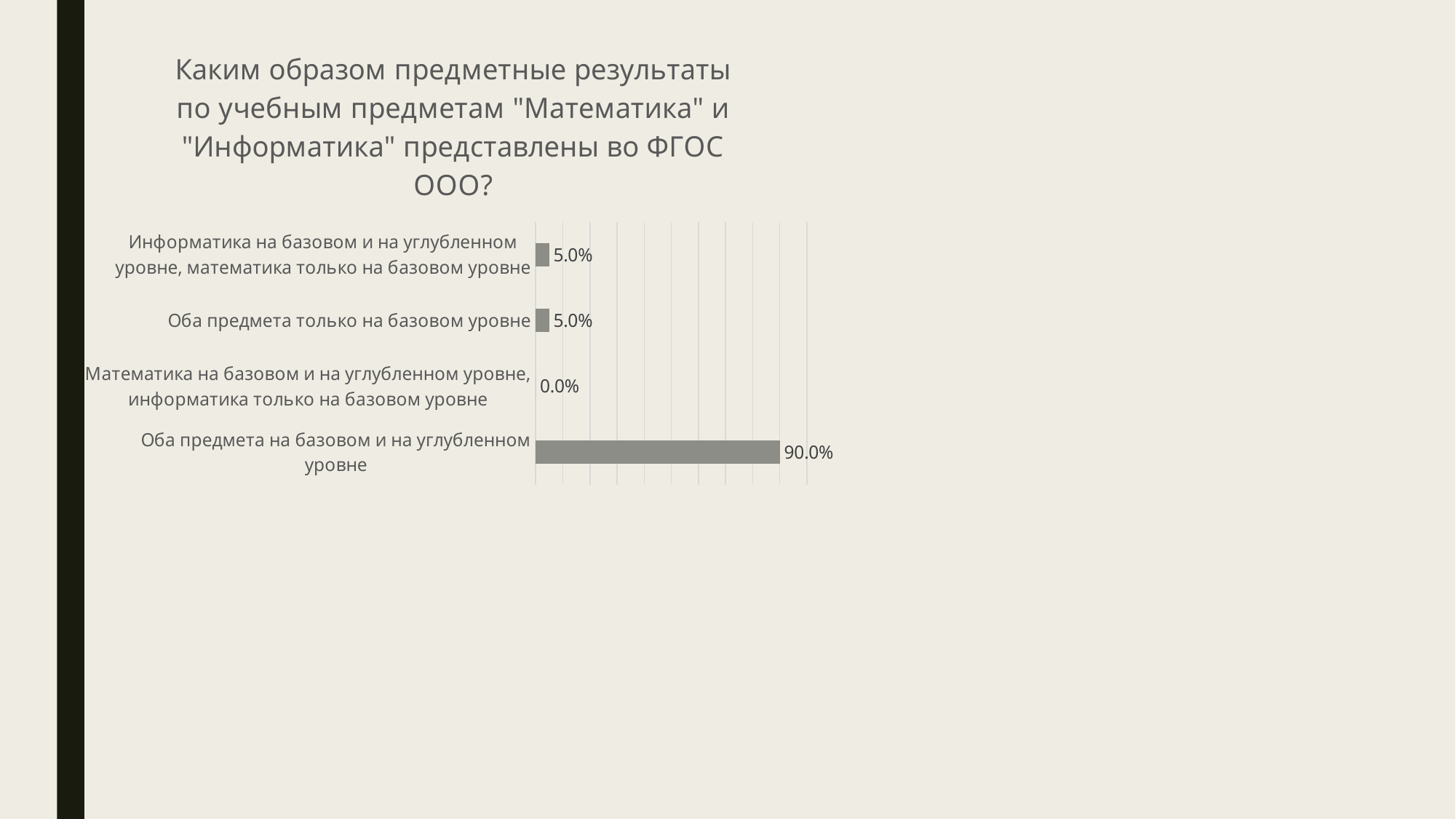
What is the value for "Оба предмета на базовом и на углубленном уровне"? 90.0% What is the value for "Информатика на базовом и на углубленном уровне, математика только на базовом уровне"? 5.0% What is the total of all four values shown in the chart? 100.0% Which category has the lowest value? Математика на базовом и на углубленном уровне, информатика только на базовом уровне How many categories are shown in the chart? 4 What is the title of the chart? Каким образом предметные результаты по учебным предметам "Математика" и "Информатика" представлены во ФГОС ООО? What is the value for "Оба предмета только на базовом уровне"? 5.0% What is the value for "Математика на базовом и на углубленном уровне, информатика только на базовом уровне"? 0.0% Which is larger: the value for "Оба предмета на базовом и на углубленном уровне" or the value for "Информатика на базовом и на углубленном уровне, математика только на базовом уровне"? Оба предмета на базовом и на углубленном уровне Which category has the highest value? Оба предмета на базовом и на углубленном уровне What is the difference between the value for "Оба предмета на базовом и на углубленном уровне" and the value for "Оба предмета только на базовом уровне"? 85.0% What kind of chart is shown on the slide? Bar chart